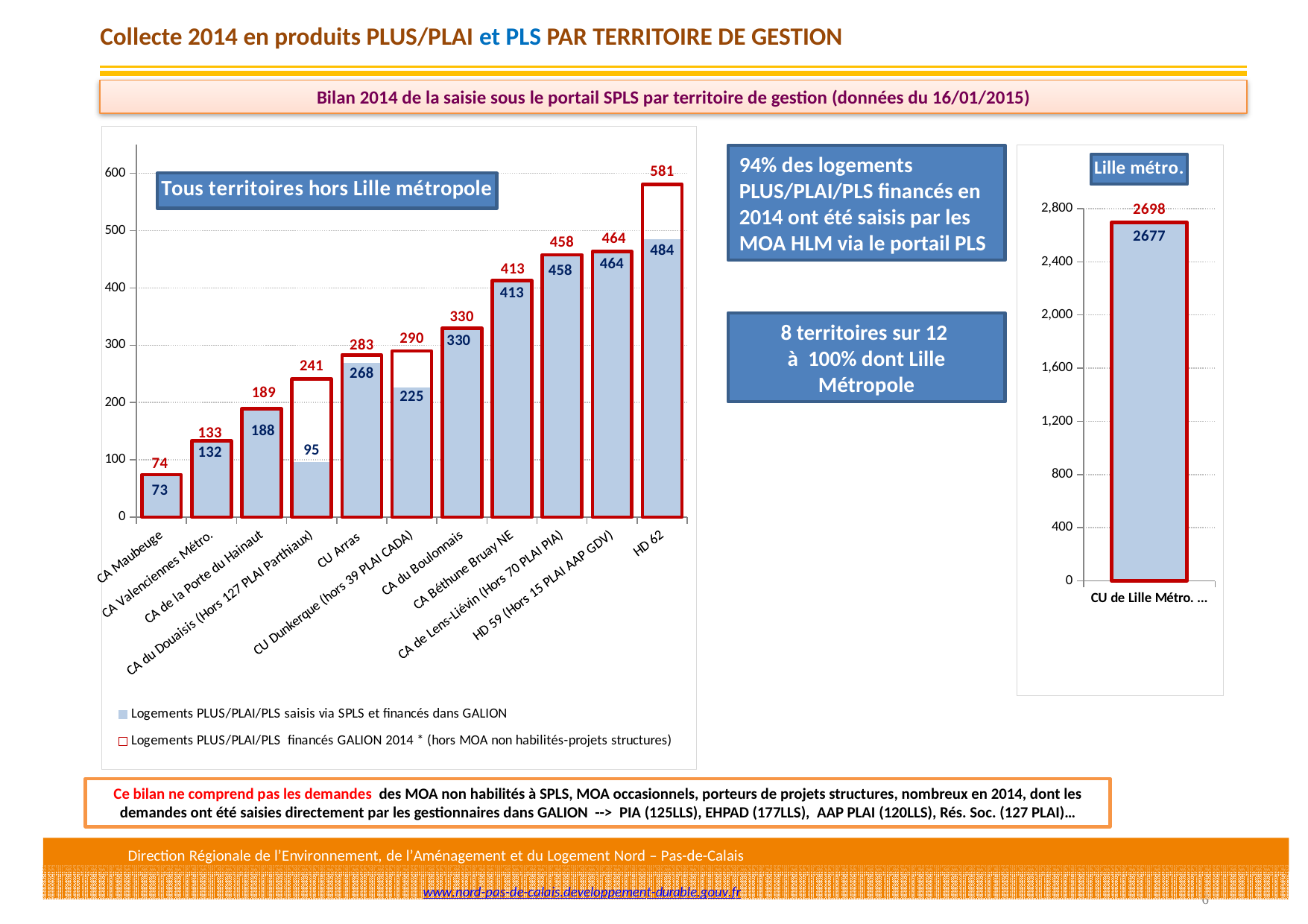
In the 'Lille métro.' chart, what is the value of Logements PLUS/PLAI/PLS saisis via SPLS et financés dans GALION for CU de Lille Métro.? 2677 In the 'Tous territoires hors Lille métropole' chart, which territory has the lowest value for Logements PLUS/PLAI/PLS saisis via SPLS et financés dans GALION? CA Maubeuge In the 'Tous territoires hors Lille métropole' chart, what is the value of Logements PLUS/PLAI/PLS financés GALION 2014 for HD 62? 581 In the 'Tous territoires hors Lille métropole' chart, what is the difference between the two series for CU Dunkerque (hors 39 PLAI CADA)? 65 What kind of chart is the 'Tous territoires hors Lille métropole' chart? Bar chart How many territories are shown on the x axis of the 'Tous territoires hors Lille métropole' chart? 11 In the 'Tous territoires hors Lille métropole' chart, what is the value of Logements PLUS/PLAI/PLS saisis via SPLS et financés dans GALION for CA du Douaisis (Hors 127 PLAI Parthiaux)? 95 In the 'Tous territoires hors Lille métropole' chart, which territory has the highest value for Logements PLUS/PLAI/PLS financés GALION 2014? HD 62 In the 'Tous territoires hors Lille métropole' chart, do the values of Logements PLUS/PLAI/PLS financés GALION 2014 rise or fall from left to right along the x axis? Rise How many series does the legend of the 'Tous territoires hors Lille métropole' chart list? 2 In the 'Tous territoires hors Lille métropole' chart, which is larger: the saisis via SPLS value for CU Arras or for CA du Boulonnais? CA du Boulonnais In the 'Lille métro.' chart, what is the difference between the financés GALION 2014 value and the saisis via SPLS value for CU de Lille Métro.? 21